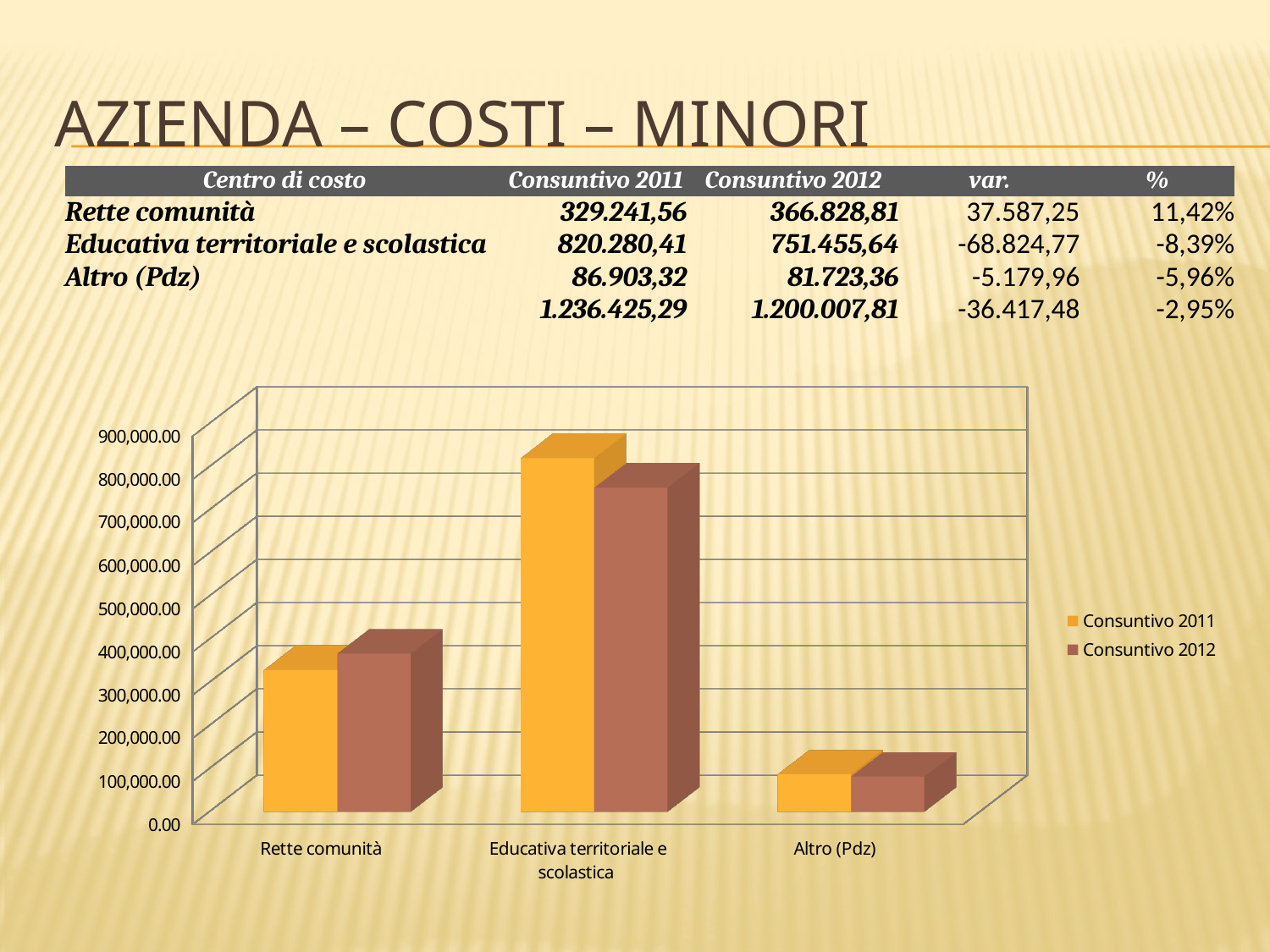
For Educativa territoriale e scolastica, which is larger: Consuntivo 2011 or Consuntivo 2012? Consuntivo 2011 Is the Consuntivo 2012 value for Educativa territoriale e scolastica greater or less than 700,000.00? greater What kind of chart is shown on the slide? bar chart How many categories are shown on the x axis of the chart? 3 Which category has the highest Consuntivo 2011 bar? Educativa territoriale e scolastica What are the two entries in the chart legend? Consuntivo 2011 and Consuntivo 2012 How many series does the chart legend list? 2 Which category has the lowest Consuntivo 2012 bar? Altro (Pdz) Is the Consuntivo 2011 value for Rette comunità greater or less than 400,000.00? less For Rette comunità, which is larger: Consuntivo 2011 or Consuntivo 2012? Consuntivo 2012 What is the difference (var.) between Consuntivo 2012 and Consuntivo 2011 for Educativa territoriale e scolastica, as printed on the slide? -68.824,77 What is the Consuntivo 2012 value for Rette comunità, as printed in the table on the slide? 366.828,81